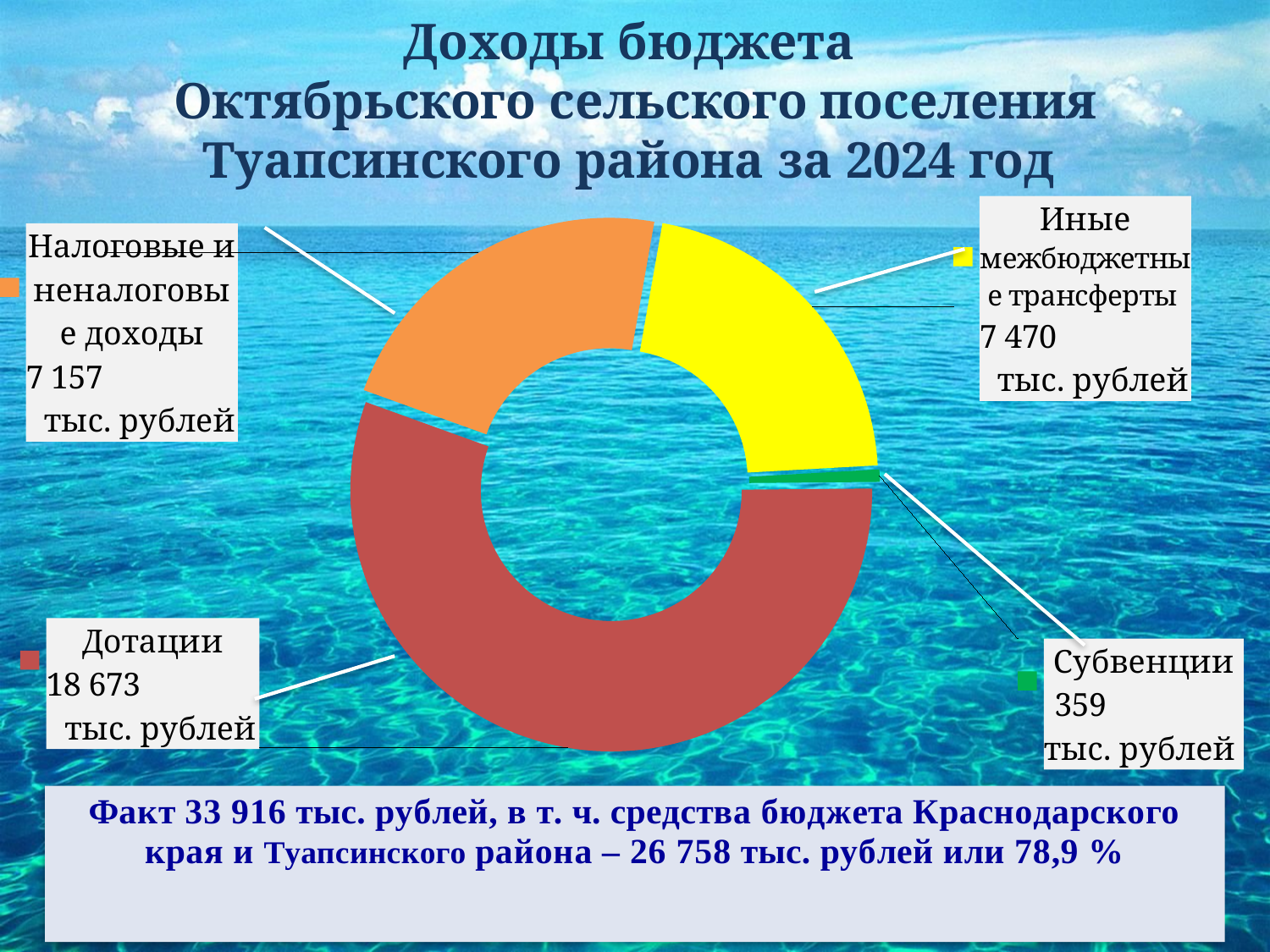
What is the value for Дотации? 18 673 тыс. рублей What kind of chart is shown on the slide? doughnut chart Which is larger: Иные межбюджетные трансферты or Налоговые и неналоговые доходы? Иные межбюджетные трансферты What colour is the Дотации segment of the chart? red Which category has the smallest value? Субвенции Which category has the largest value? Дотации What is the difference between Дотации and Иные межбюджетные трансферты? 11 203 тыс. рублей What is the value for Субвенции? 359 тыс. рублей What is the value for Налоговые и неналоговые доходы? 7 157 тыс. рублей How many categories does the chart show? 4 What is the difference between Иные межбюджетные трансферты and Налоговые и неналоговые доходы? 313 тыс. рублей What is the value for Иные межбюджетные трансферты? 7 470 тыс. рублей